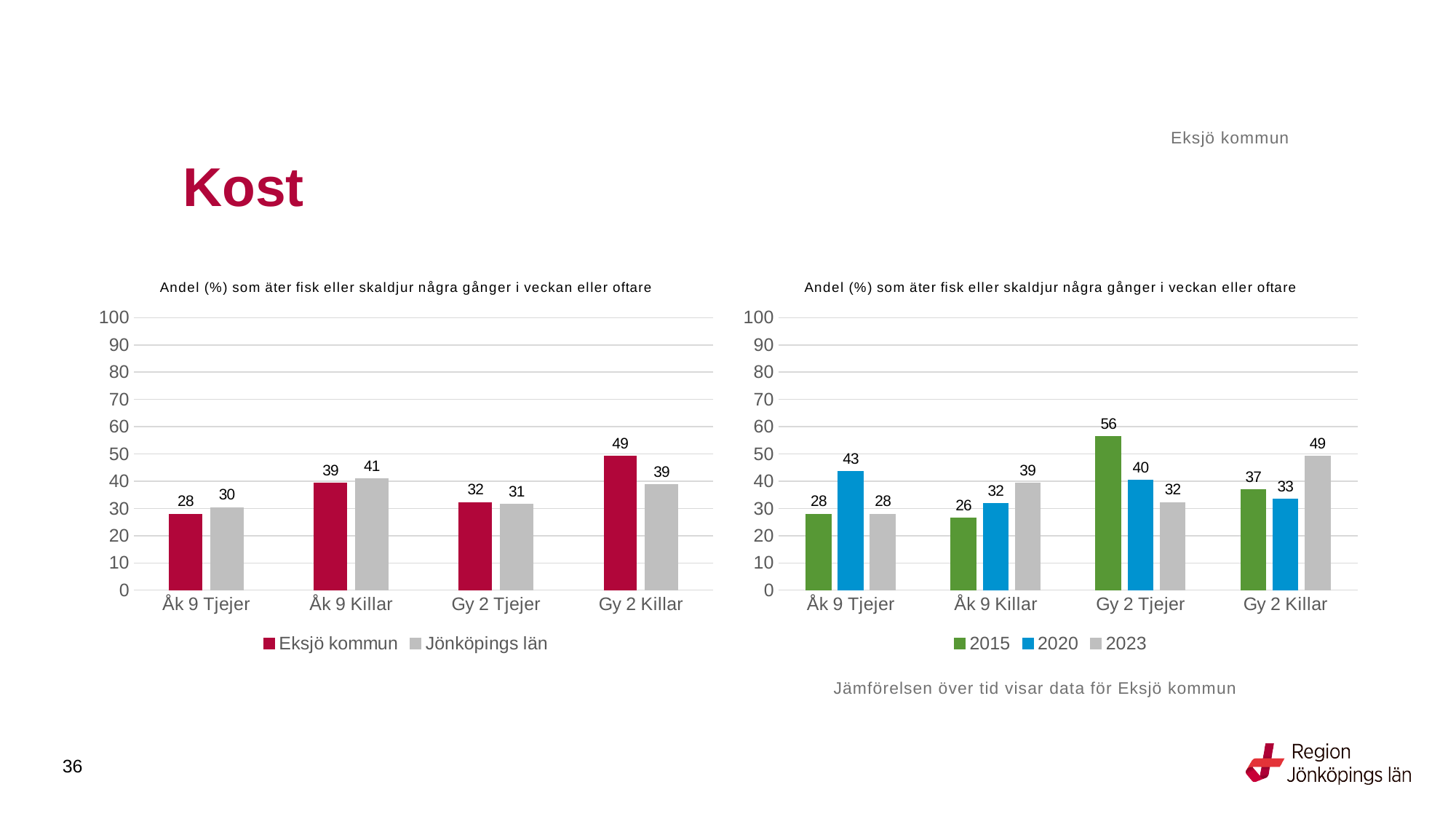
What kind of chart is the right chart? Bar chart In the left chart, which category has the highest value for Eksjö kommun? Gy 2 Killar In the right chart, what is the value for 2015 for Gy 2 Tjejer? 56 In the right chart, how many categories are shown on the x axis? 4 In the right chart, what is the value for 2023 for Åk 9 Killar? 39 In the left chart, which is larger for Åk 9 Tjejer: Eksjö kommun or Jönköpings län? Jönköpings län In the left chart, what is the value for Eksjö kommun for Gy 2 Killar? 49 In the right chart, what is the difference between 2015 and 2023 for Gy 2 Tjejer? 24 In the right chart, which category has the lowest value for 2015? Åk 9 Killar In the left chart, what is the difference between Eksjö kommun and Jönköpings län for Gy 2 Killar? 10 In the left chart, how many series does the legend list? 2 In the left chart, what is the value for Jönköpings län for Åk 9 Killar? 41